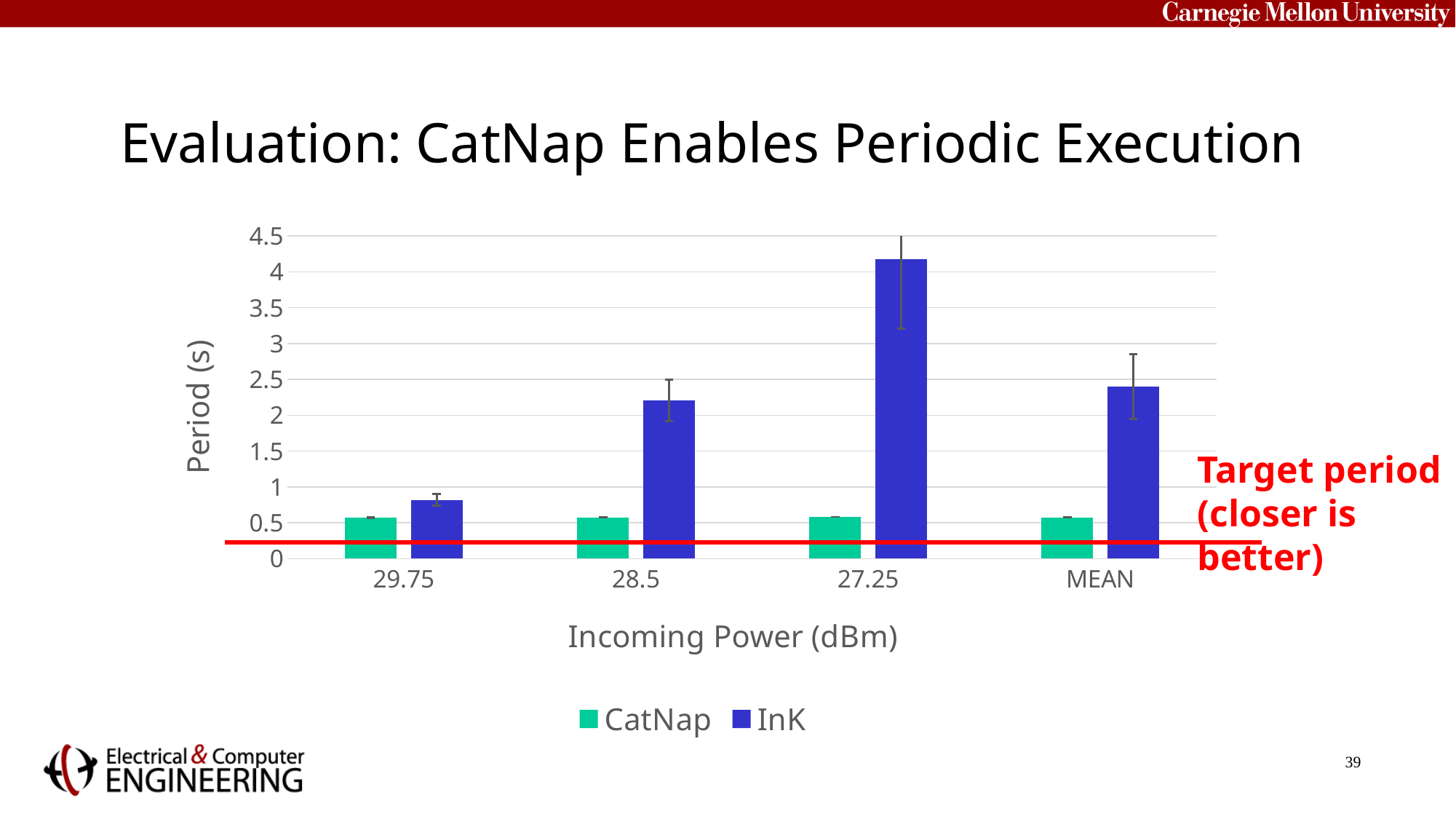
What is the label of the y axis? Period (s) Does the InK period rise or fall as incoming power goes from 29.75 to 27.25 dBm? rise Is the InK value at 28.5 dBm greater or less than 2? greater What kind of chart is shown on the slide? bar chart How many categories are shown on the x axis? 4 Is the CatNap value for MEAN greater or less than 1? less Is the InK value at 27.25 dBm greater or less than 3.5? greater How many series does the legend list? 2 At which incoming power is the InK period lowest? 29.75 At which incoming power is the InK period highest? 27.25 At 28.5 dBm, which has the larger period, CatNap or InK? InK